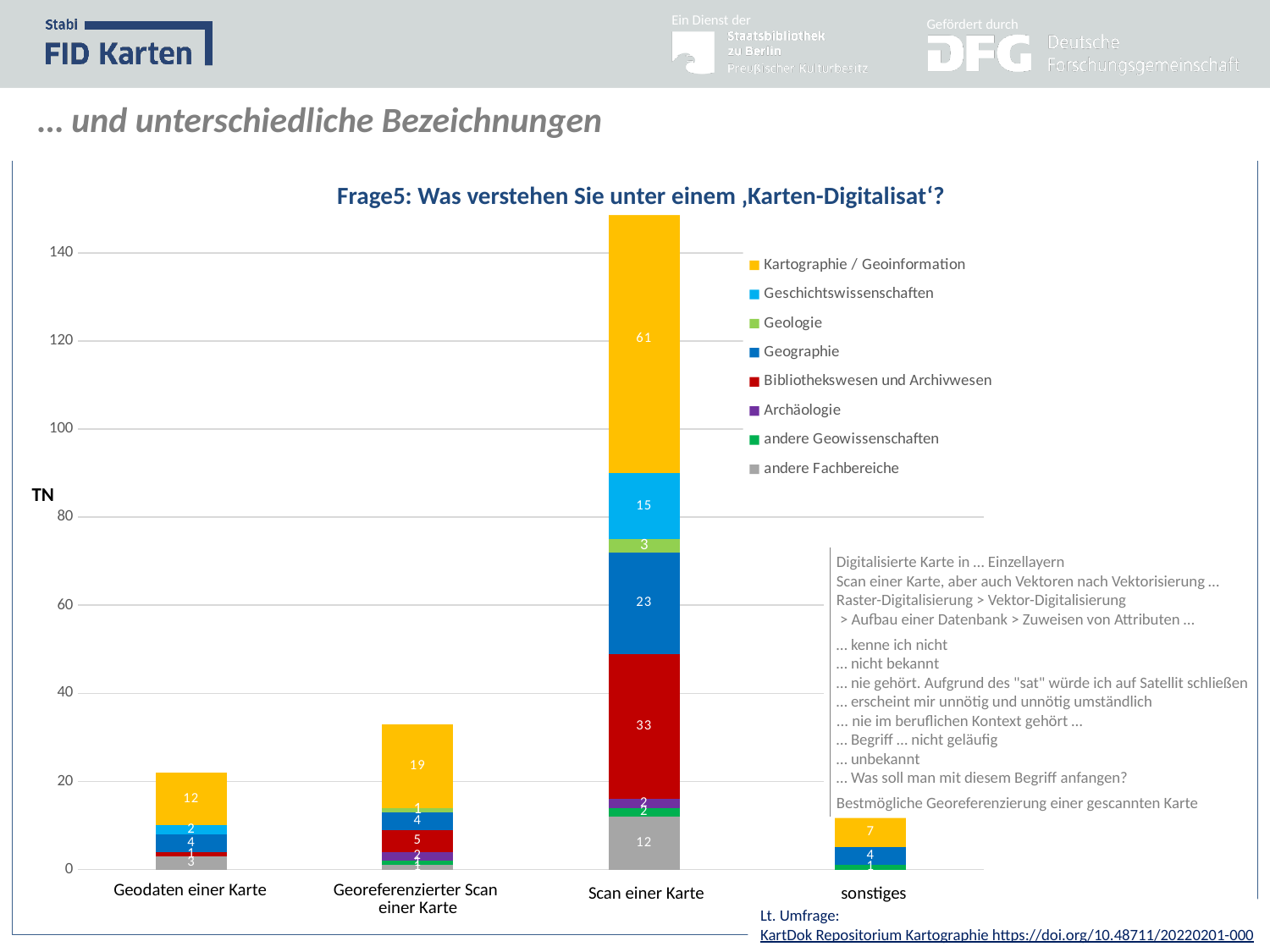
What is the value for Geographie in the 'Scan einer Karte' bar? 23 What is the value for Geschichtswissenschaften in the 'Scan einer Karte' bar? 15 How many categories are shown on the x axis? 4 Is the total of the 'Scan einer Karte' bar greater or less than 140? greater In the 'Scan einer Karte' bar, what is the difference between the Kartographie / Geoinformation value and the Bibliothekswesen und Archivwesen value? 28 Is the Kartographie / Geoinformation value larger for 'Geodaten einer Karte' or for 'Georeferenzierter Scan einer Karte'? Georeferenzierter Scan einer Karte What is the value for Kartographie / Geoinformation in the 'Scan einer Karte' bar? 61 Which category has the shortest stacked bar? sonstiges What is the value for Bibliothekswesen und Archivwesen in the 'Scan einer Karte' bar? 33 Which category has the tallest stacked bar? Scan einer Karte What is the value for Kartographie / Geoinformation in the 'Georeferenzierter Scan einer Karte' bar? 19 How many series does the legend list? 8